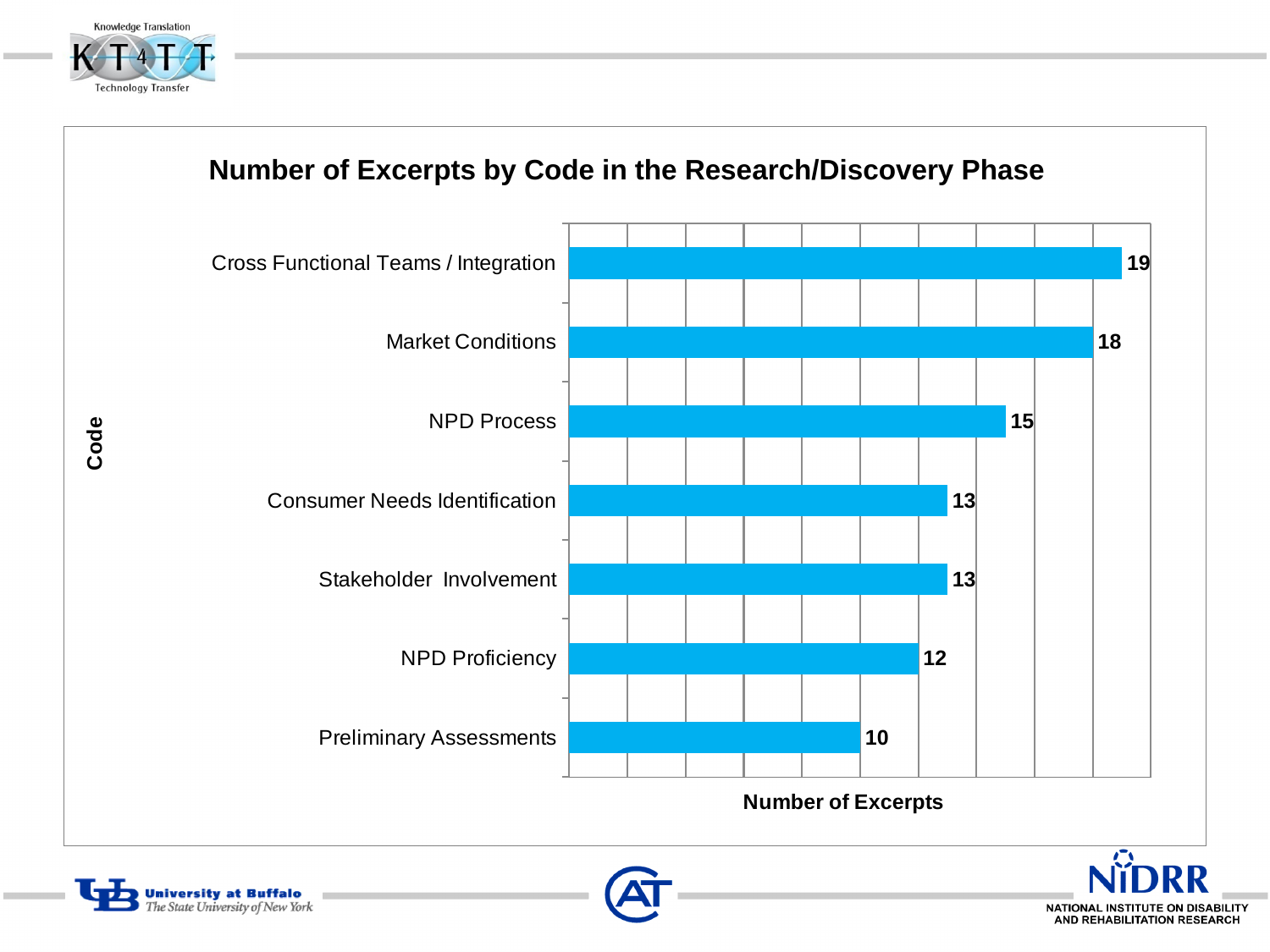
What kind of chart is shown on the slide? Bar chart How many codes are shown in the chart? 7 What is the difference in number of excerpts between Market Conditions and NPD Proficiency? 6 Which code has the lowest number of excerpts? Preliminary Assessments What is the number of excerpts for Market Conditions? 18 What is the title of the chart? Number of Excerpts by Code in the Research/Discovery Phase What is the label of the horizontal axis? Number of Excerpts Which code has the highest number of excerpts? Cross Functional Teams / Integration What is the number of excerpts for Preliminary Assessments? 10 Which has more excerpts, NPD Process or Consumer Needs Identification? NPD Process What is the difference in number of excerpts between Cross Functional Teams / Integration and Preliminary Assessments? 9 What is the number of excerpts for NPD Process? 15